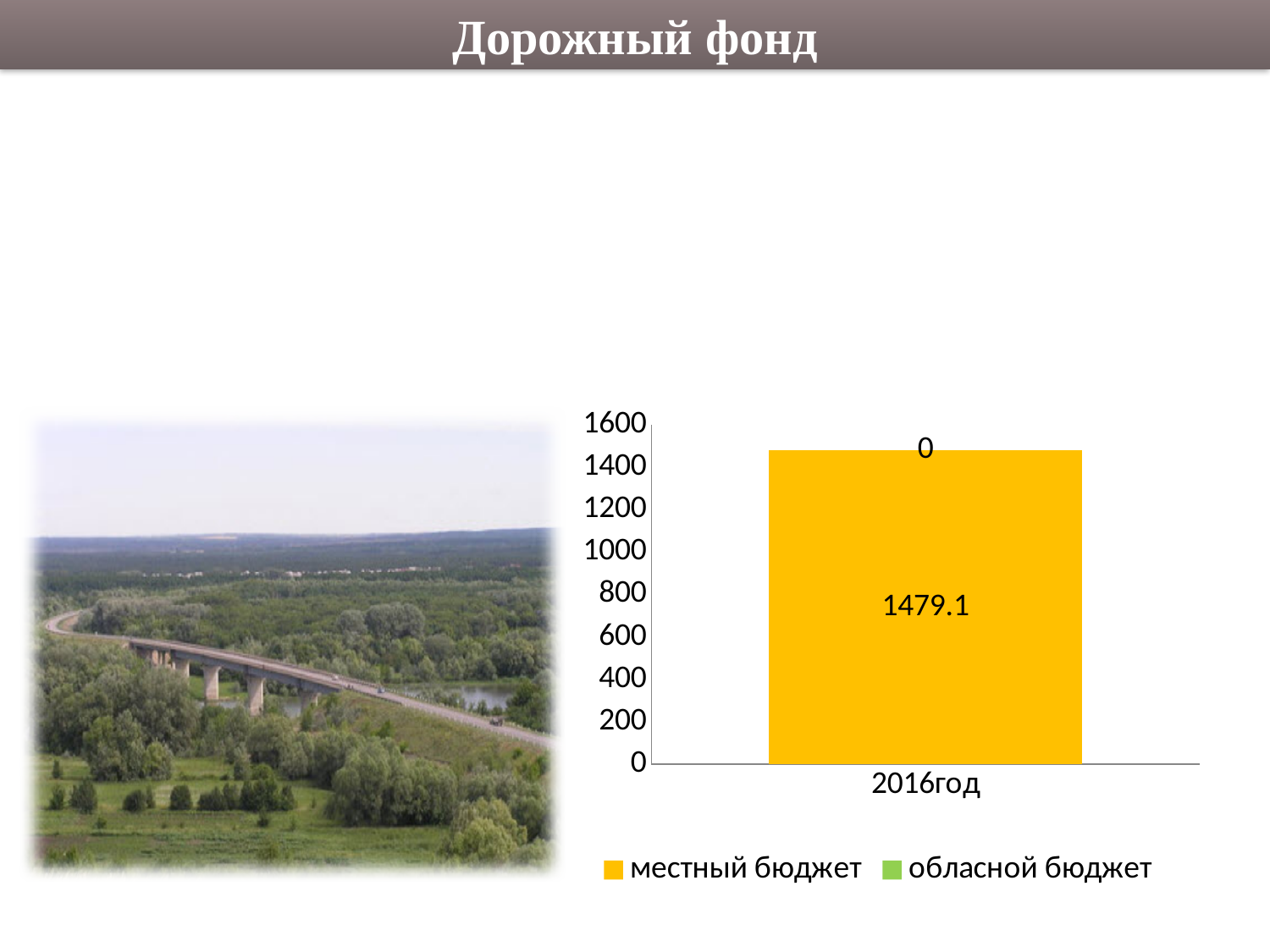
What is the total of the stacked bar for 2016год? 1479.1 What is the title of the slide containing the chart? Дорожный фонд What is the difference between местный бюджет and обласной бюджет in 2016год? 1479.1 Is the value for местный бюджет in 2016год greater or less than 1400? greater What is the value for обласной бюджет in 2016год? 0 What colour represents местный бюджет in the legend? yellow Which series has the larger value in 2016год, местный бюджет or обласной бюджет? местный бюджет Is the value for местный бюджет in 2016год greater or less than 1600? less How many series does the legend list? 2 How many categories are shown on the x axis? 1 What kind of chart is shown on the slide? bar chart What is the value for местный бюджет in 2016год? 1479.1